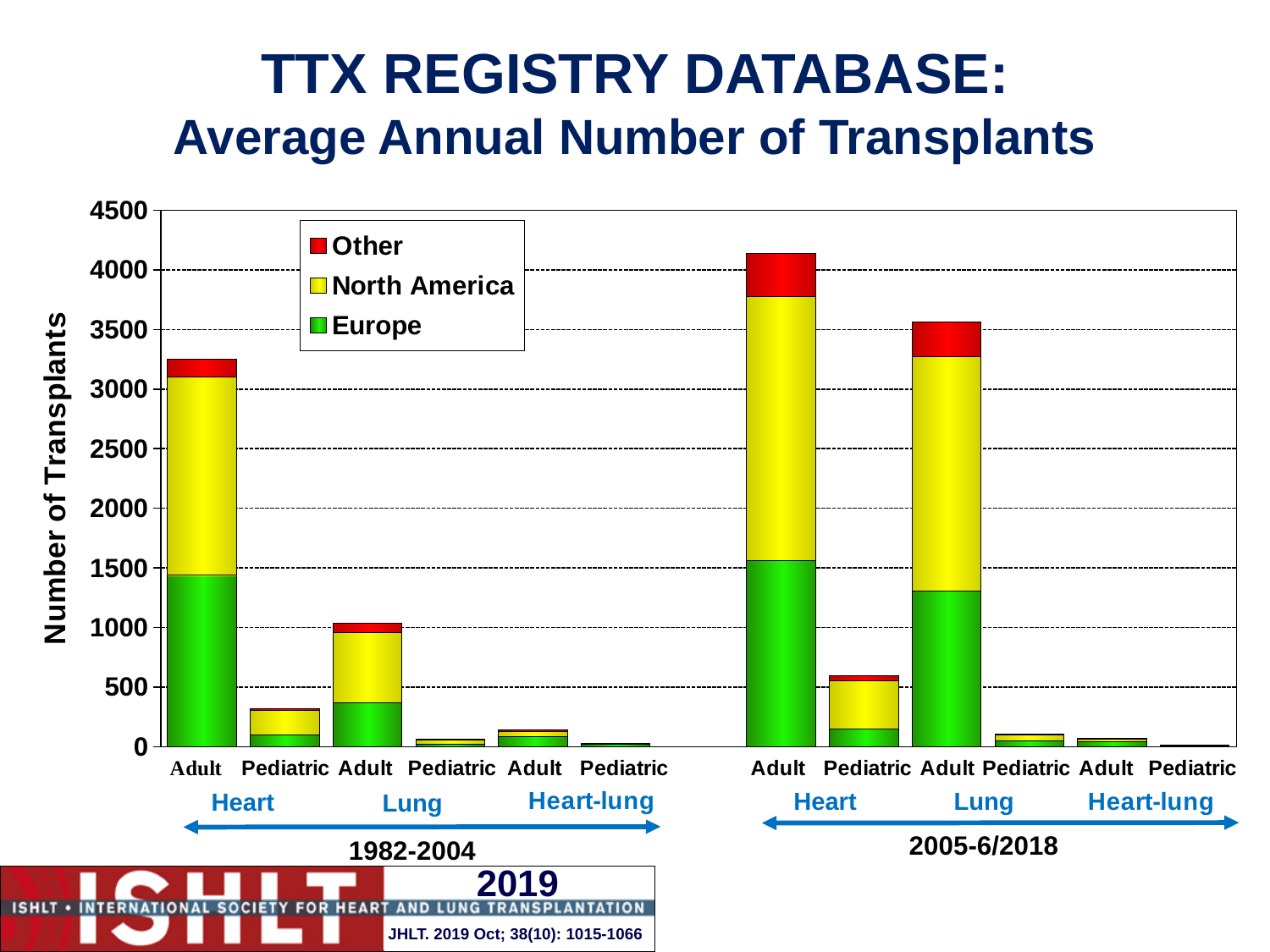
Is the total for Adult Heart in 1982-2004 greater or less than 3000? greater Is the total for Pediatric Heart in 1982-2004 greater or less than 500? less How many bars are plotted in the chart? 12 Is the total for Adult Lung in 2005-6/2018 greater or less than 3000? greater What is the title of the y axis? Number of Transplants Which bar has the lowest total number of transplants? Pediatric Heart-lung, 2005-6/2018 How many series does the legend list? 3 What kind of chart is shown on the slide? stacked bar chart Which is larger: the total for Adult Lung in 1982-2004 or the total for Adult Lung in 2005-6/2018? Adult Lung in 2005-6/2018 Which bar has the highest total number of transplants? Adult Heart, 2005-6/2018 Which is larger: the total for Adult Heart in 1982-2004 or the total for Adult Heart in 2005-6/2018? Adult Heart in 2005-6/2018